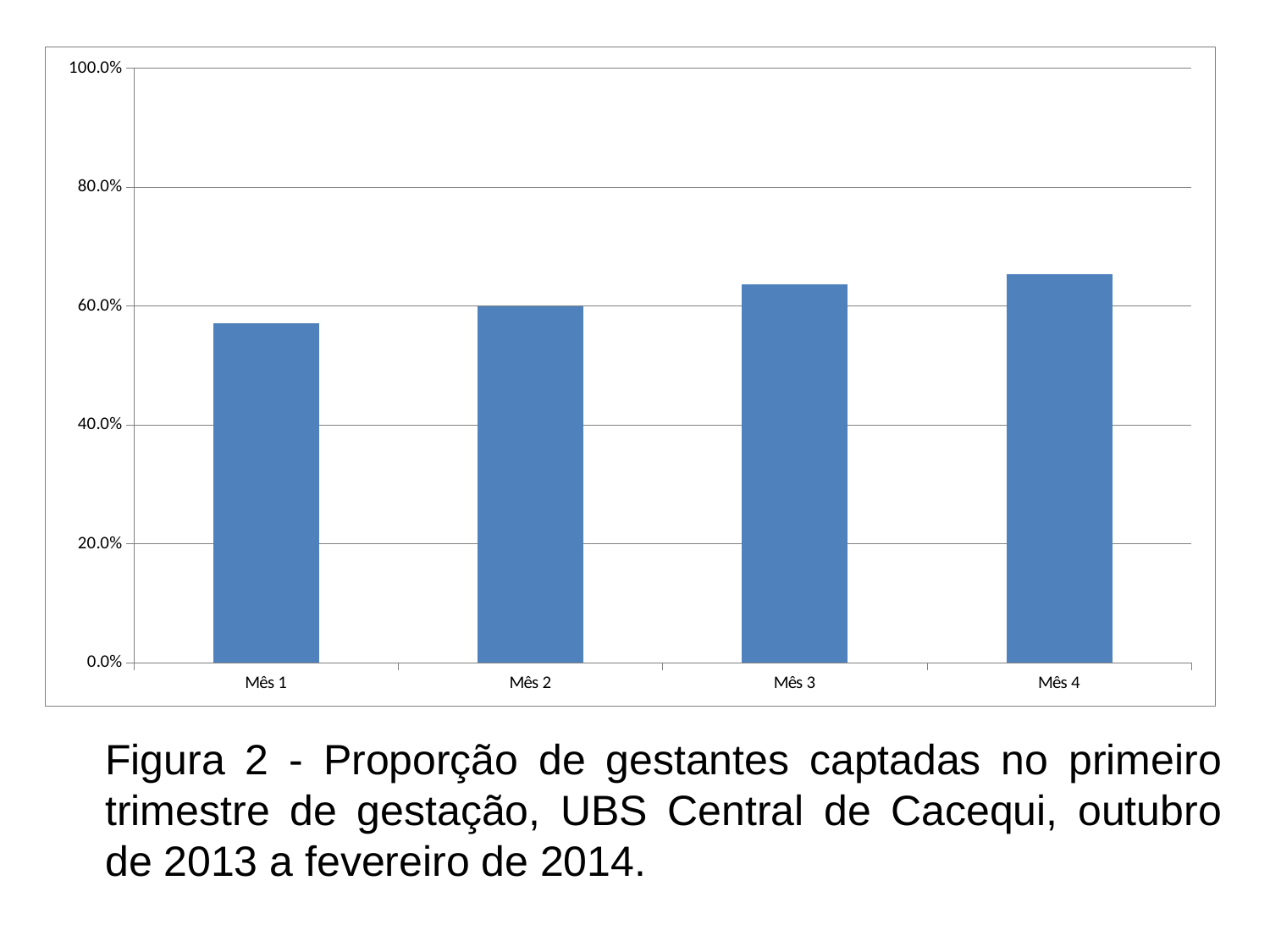
Which is larger, the value for Mês 1 or the value for Mês 4? Mês 4 Is the value for Mês 1 greater or less than 40.0%? greater Is the value for Mês 1 greater or less than 60.0%? less How many categories (months) are plotted on the x axis? 4 What is the figure number given in the caption below the chart? Figura 2 Is the value for Mês 3 greater or less than 60.0%? greater Do the values rise or fall from Mês 1 to Mês 4? rise Which month has the highest bar? Mês 4 What is the highest value shown on the y axis? 100.0% Which month has the lowest bar? Mês 1 What kind of chart is shown on the slide? bar chart